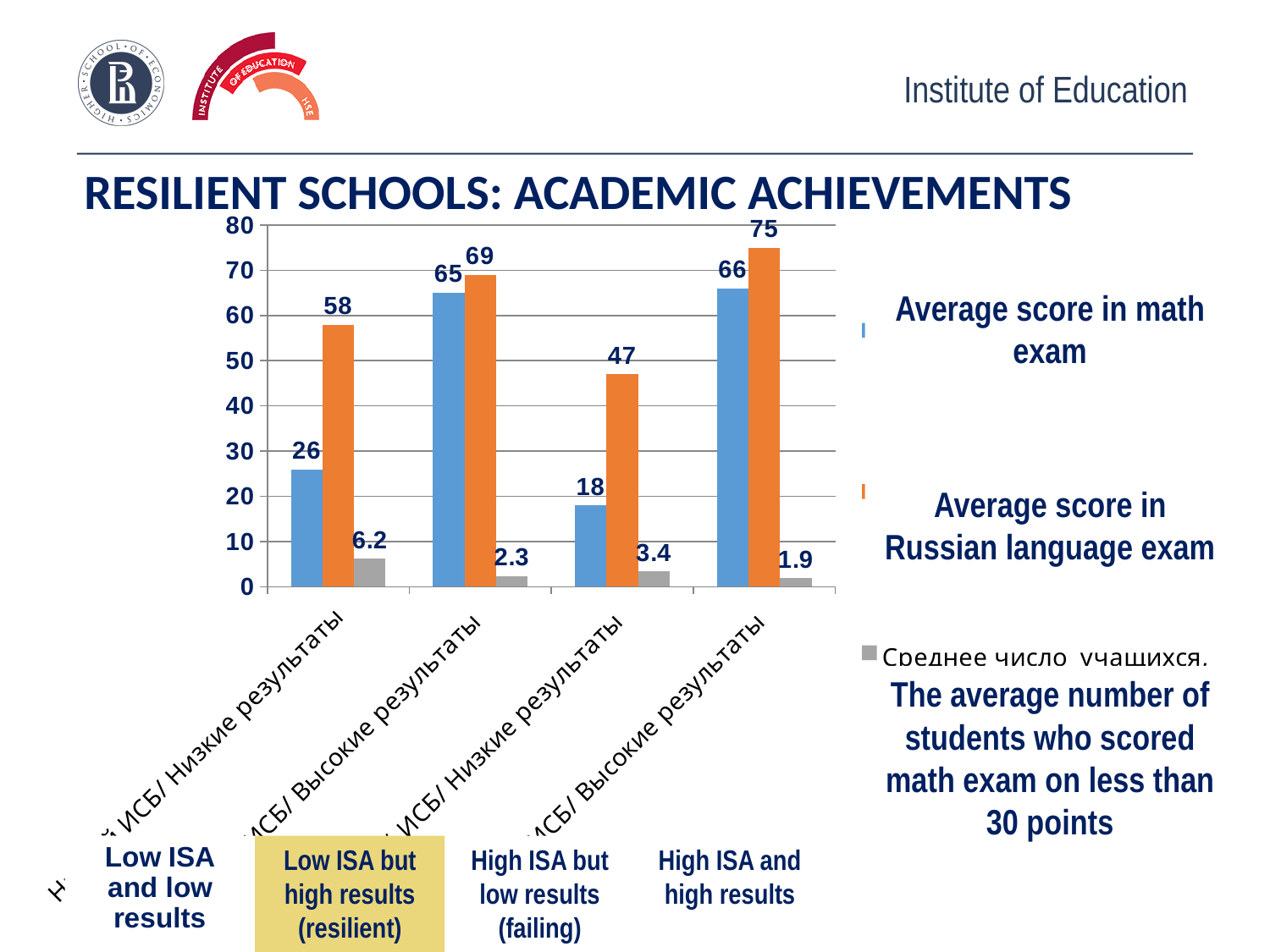
How many groups (categories) are shown on the x axis of the chart? 4 What is the average number of students who scored less than 30 points in the math exam for the 'Low ISA and low results' group? 6.2 What is the average score in the Russian language exam for the 'High ISA and high results' group? 75 Which is larger for the 'High ISA and high results' group: the average math exam score or the average Russian language exam score? Average score in Russian language exam What type of chart is shown on the slide? Bar chart Which group has the lowest average score in the math exam? High ISA but low results (failing) What is the difference between the Russian language exam score and the math exam score for the 'Low ISA and low results' group? 32 How many data series does the chart's legend list? 3 Which colour represents the average score in the math exam in the chart? Blue What is the average score in the math exam for the 'Low ISA but high results (resilient)' group? 65 What is the average score in the Russian language exam for the 'High ISA but low results (failing)' group? 47 Which group has the highest average score in the Russian language exam? High ISA and high results